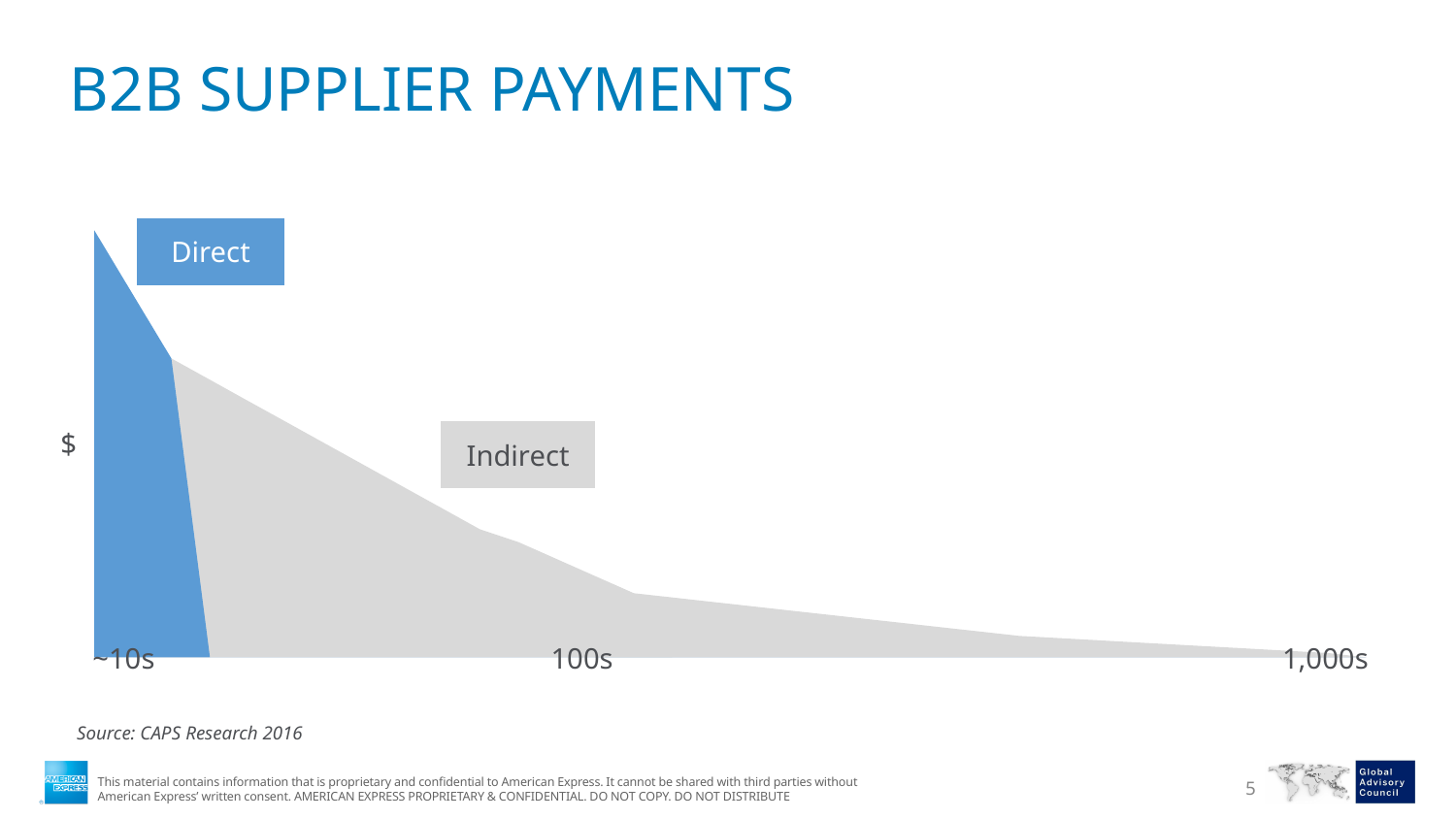
What is the label on the y axis of the chart? $ What is the leftmost label on the x axis of the chart? ~10s What is the rightmost label on the x axis of the chart? 1,000s Do the values in the chart rise or fall moving from left to right along the x axis? Fall What is the middle label on the x axis of the chart? 100s What kind of chart is shown on the slide? Area chart What are the two segments labelled in the chart? Direct and Indirect What is the title of the chart on the slide? B2B SUPPLIER PAYMENTS How many labelled segments does the chart show? 2 What source is cited for the chart? CAPS Research 2016 Which segment reaches higher on the $ axis, Direct or Indirect? Direct How many labels are shown along the x axis of the chart? 3